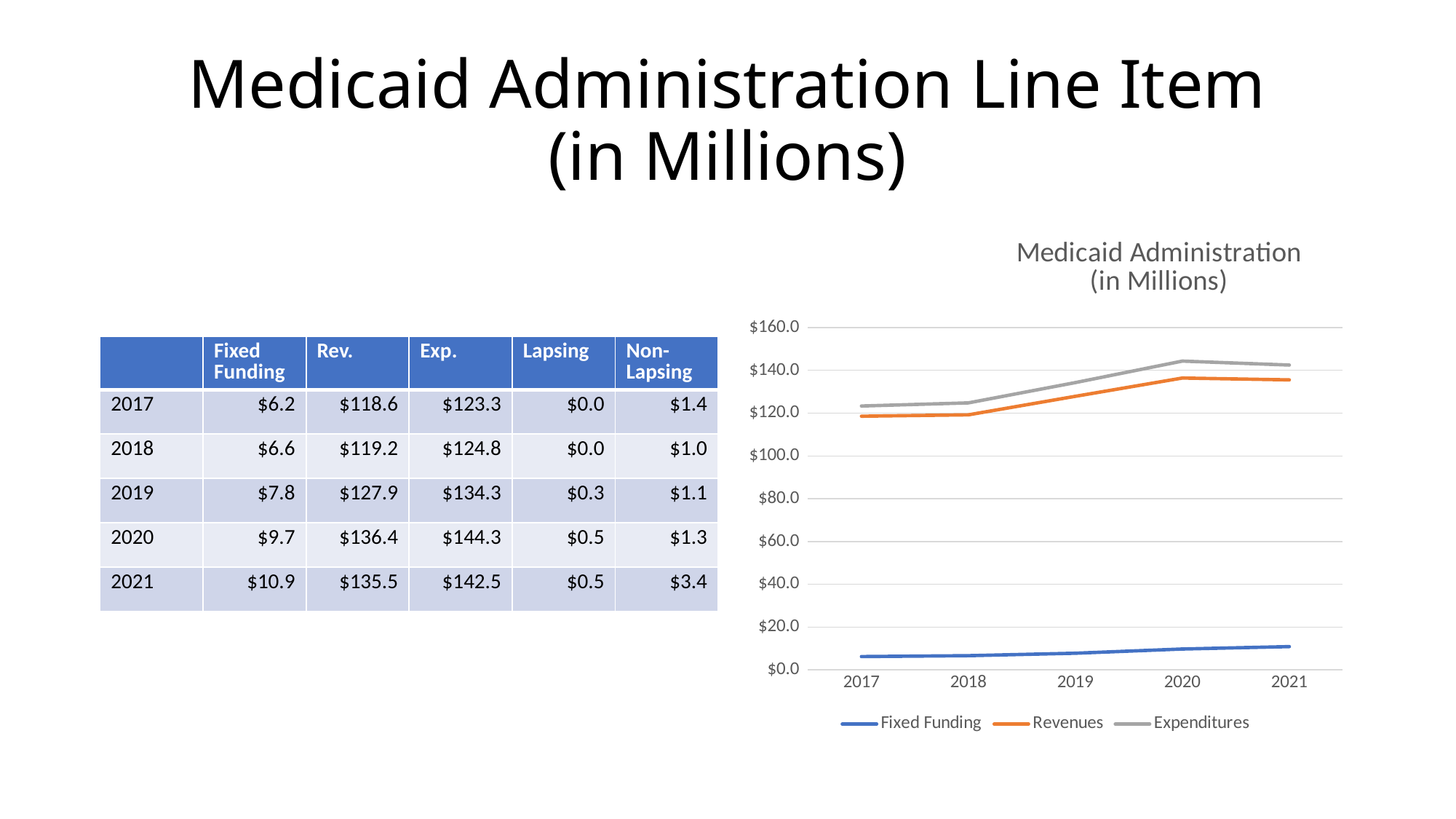
What is the title of the chart? Medicaid Administration (in Millions) Is the value for Revenues in 2017 greater or less than $120.0? less How many years are plotted along the x axis of the chart? 5 What colour is the Revenues line in the chart? orange In 2019, which is larger, Revenues or Expenditures? Expenditures What kind of chart is shown on the slide? line chart Which series has the highest values in the chart? Expenditures How many series does the chart legend list? 3 Is the value for Fixed Funding in 2021 greater or less than $20.0? less Is the value for Expenditures in 2020 greater or less than $140.0? greater Which series has the lowest values in the chart? Fixed Funding Does the Fixed Funding line rise or fall from 2017 to 2021? rise